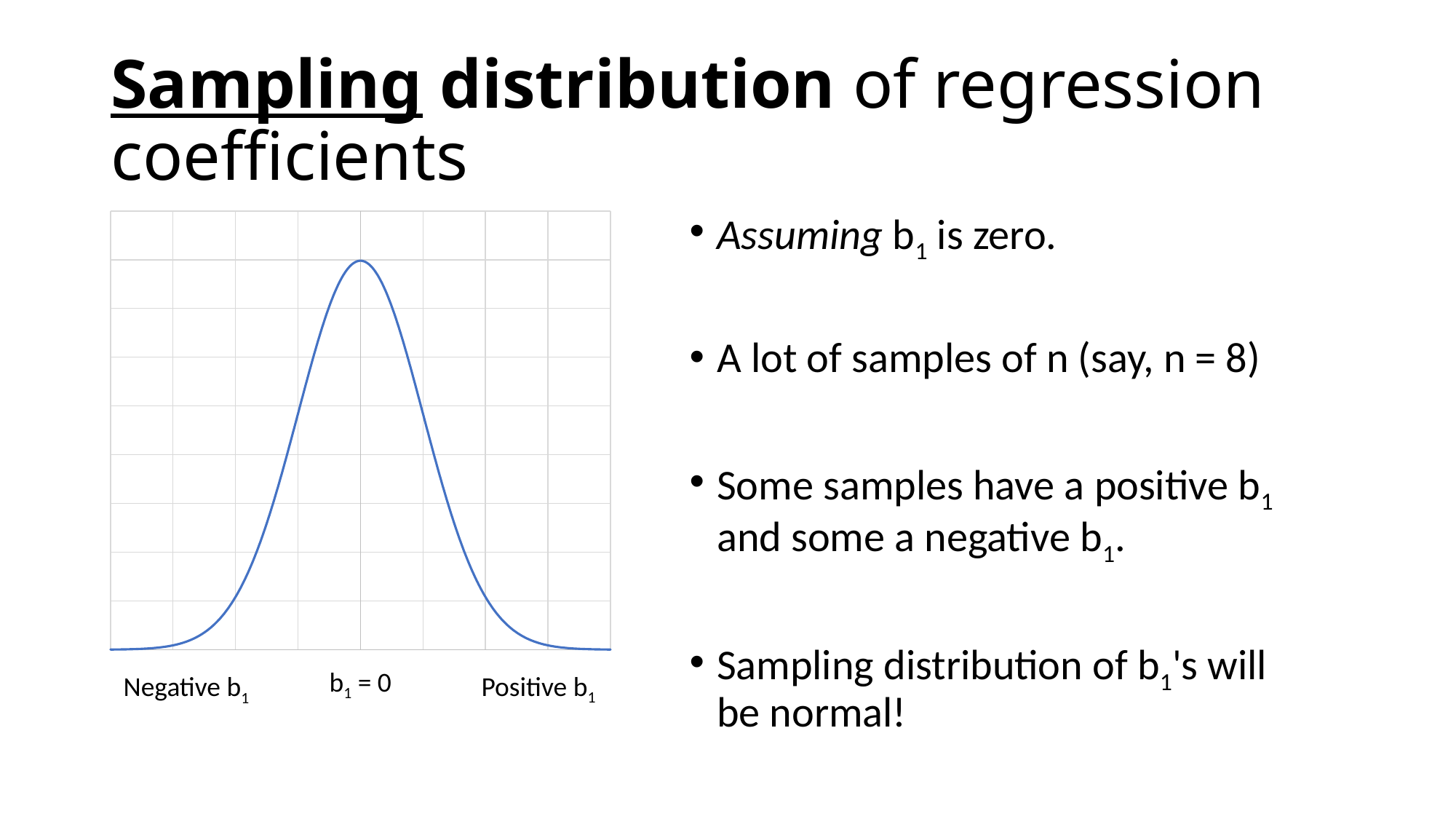
How many labels are shown along the x axis of the chart? 3 Moving from b1 = 0 toward Positive b1, does the curve rise or fall? fall What is the label at the left end of the chart's x axis? Negative b1 What kind of chart is shown on the slide? line chart At which x-axis label does the curve reach its highest point? b1 = 0 Is the curve higher at Positive b1 or at b1 = 0? b1 = 0 Is the curve higher at b1 = 0 or at Negative b1? b1 = 0 What colour is the plotted curve? blue How many lines are plotted on the chart? 1 Moving from left to right along the x axis, does the curve rise or fall before reaching b1 = 0? rise